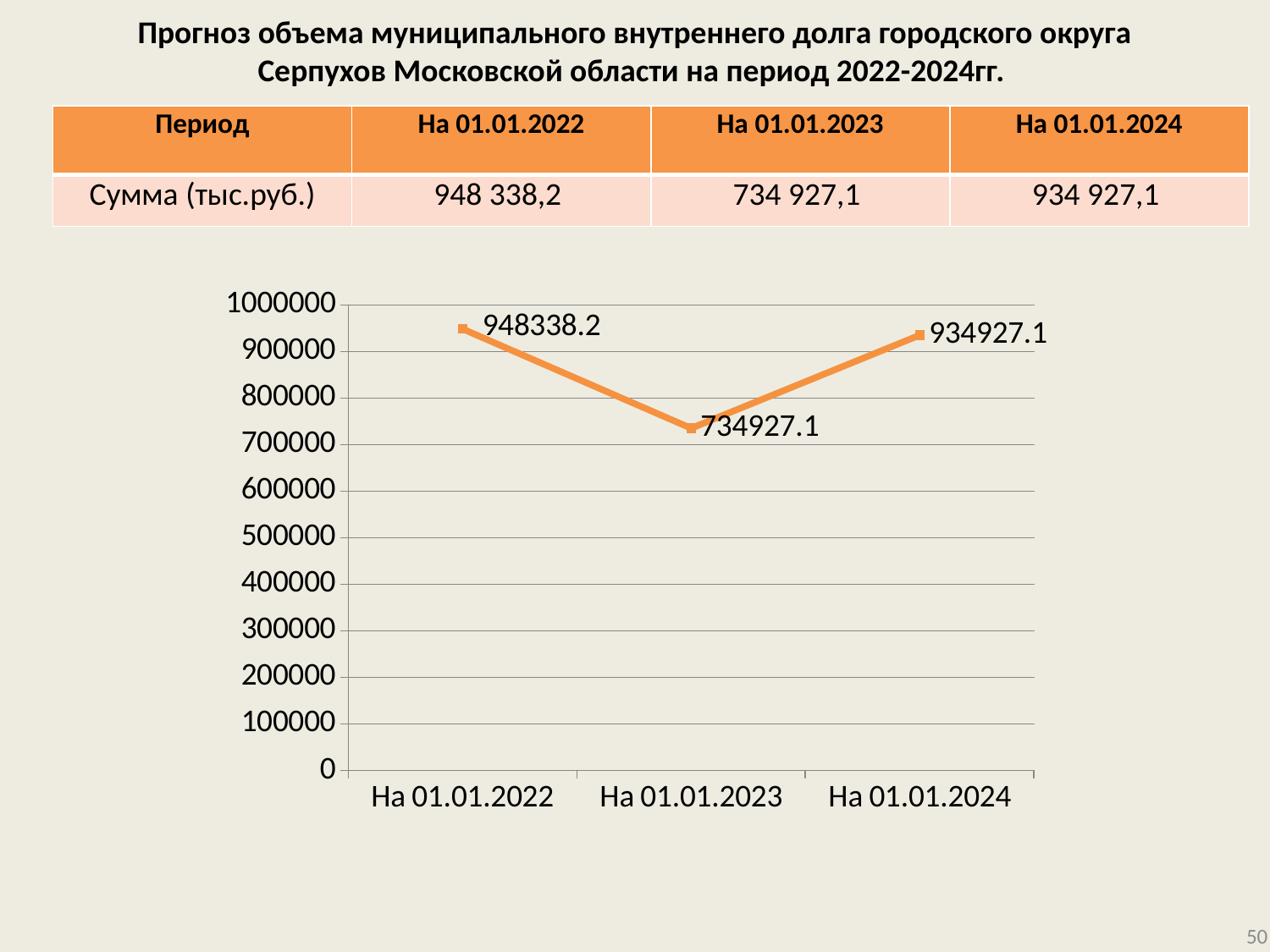
What kind of chart is shown on the slide? line chart Which is larger, the value for На 01.01.2022 or the value for На 01.01.2024? На 01.01.2022 Which period has the highest plotted value? На 01.01.2022 What is the value plotted for На 01.01.2024? 934927.1 Which period has the lowest plotted value? На 01.01.2023 What is the difference between the values for На 01.01.2024 and На 01.01.2023? 200000 What is the value plotted for На 01.01.2022? 948338.2 What is the difference between the values for На 01.01.2022 and На 01.01.2023? 213411.1 What is the value plotted for На 01.01.2023? 734927.1 How does the plotted value change from На 01.01.2022 to На 01.01.2023 and then to На 01.01.2024? It falls, then rises How many data points are plotted on the chart? 3 Is the value for На 01.01.2023 greater or less than 800000? less